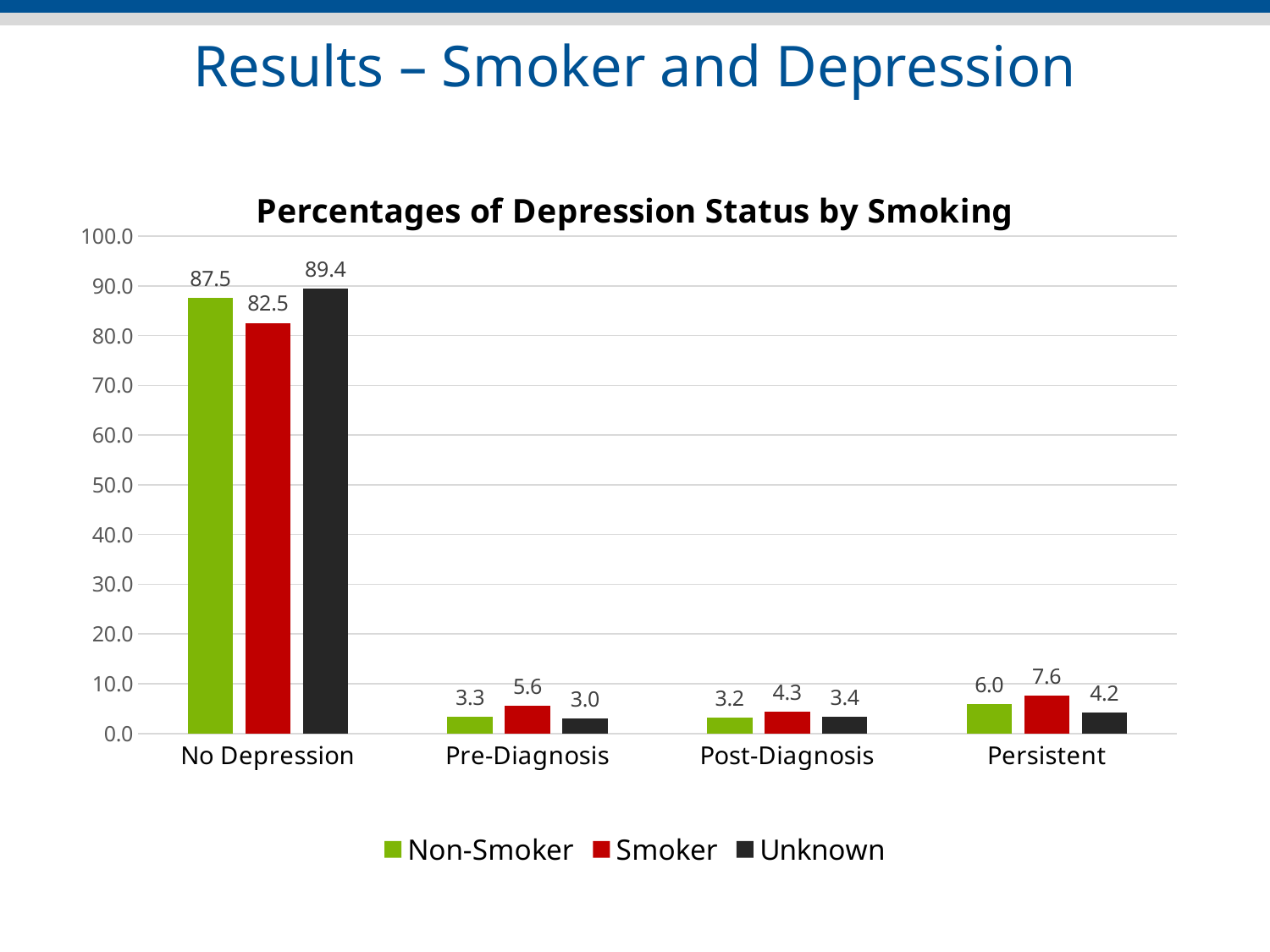
Is the value for Smoker in the No Depression category greater or less than 90.0? less Which series has the highest value in the No Depression category? Unknown How many series does the legend list? 3 What is the value for Smoker in the Persistent category? 7.6 What is the value for Unknown in the Pre-Diagnosis category? 3.0 What is the value for Non-Smoker in the No Depression category? 87.5 What kind of chart is shown on the slide? bar chart How many categories are shown on the x axis? 4 What is the title of the chart? Percentages of Depression Status by Smoking What is the difference between the Unknown and Smoker values in the No Depression category? 6.9 Which series has the lowest value in the Post-Diagnosis category? Non-Smoker Which is larger: the Smoker value for Pre-Diagnosis or the Smoker value for Post-Diagnosis? Pre-Diagnosis